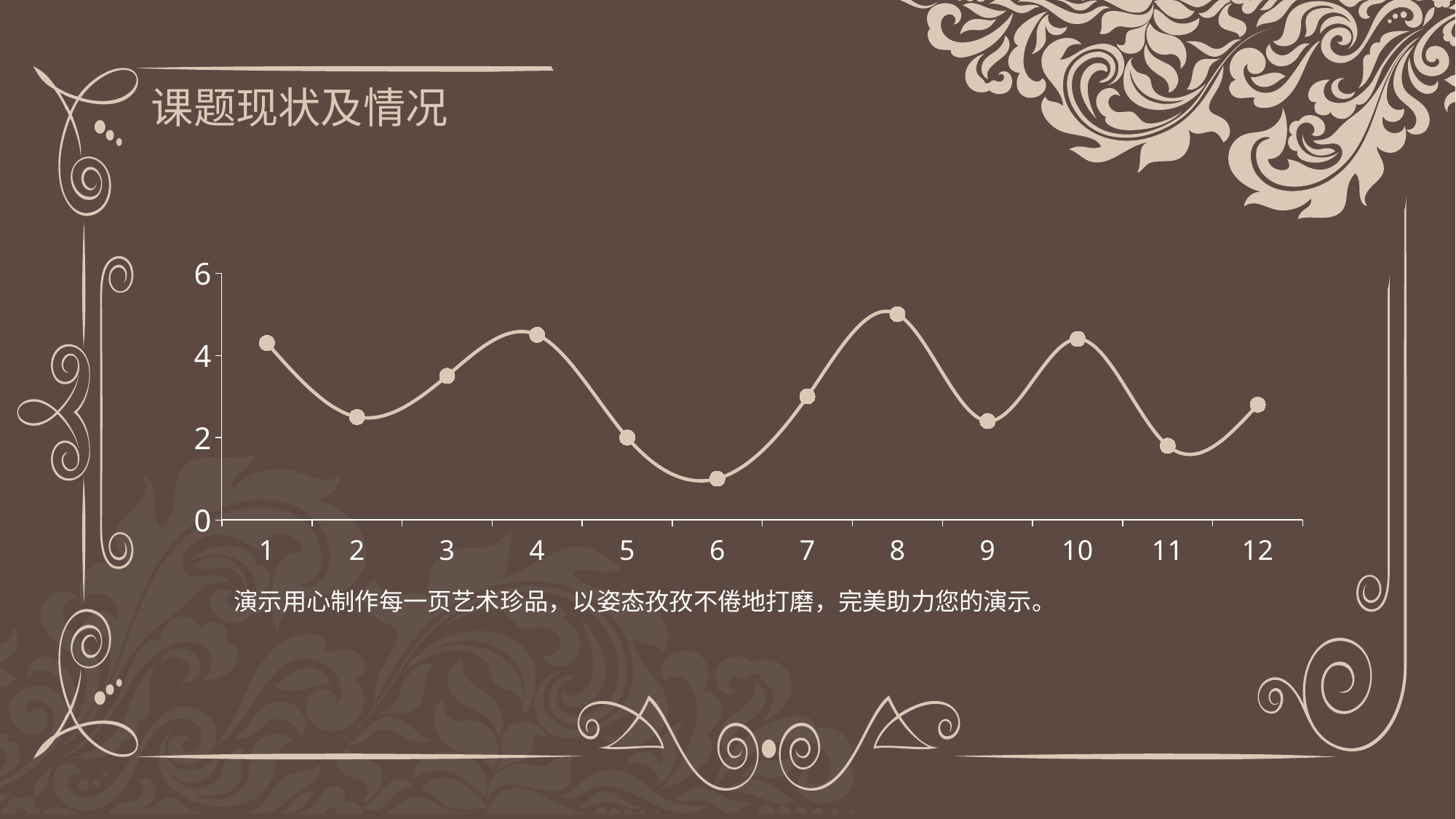
Do the values rise or fall from x = 4 to x = 6? fall Which x-axis category has the lowest value on the line chart? 6 How many data points are plotted on the line chart? 12 What kind of chart is shown on the slide? line chart Which has the larger value, x = 1 or x = 2? 1 Is the value at x = 8 greater or less than 4? greater Which has the larger value, x = 10 or x = 12? 10 Which x-axis category has the highest value on the line chart? 8 What is the title of the slide containing the chart? 课题现状及情况 Is the value at x = 2 greater or less than 2? greater Is the value at x = 4 greater or less than 4? greater